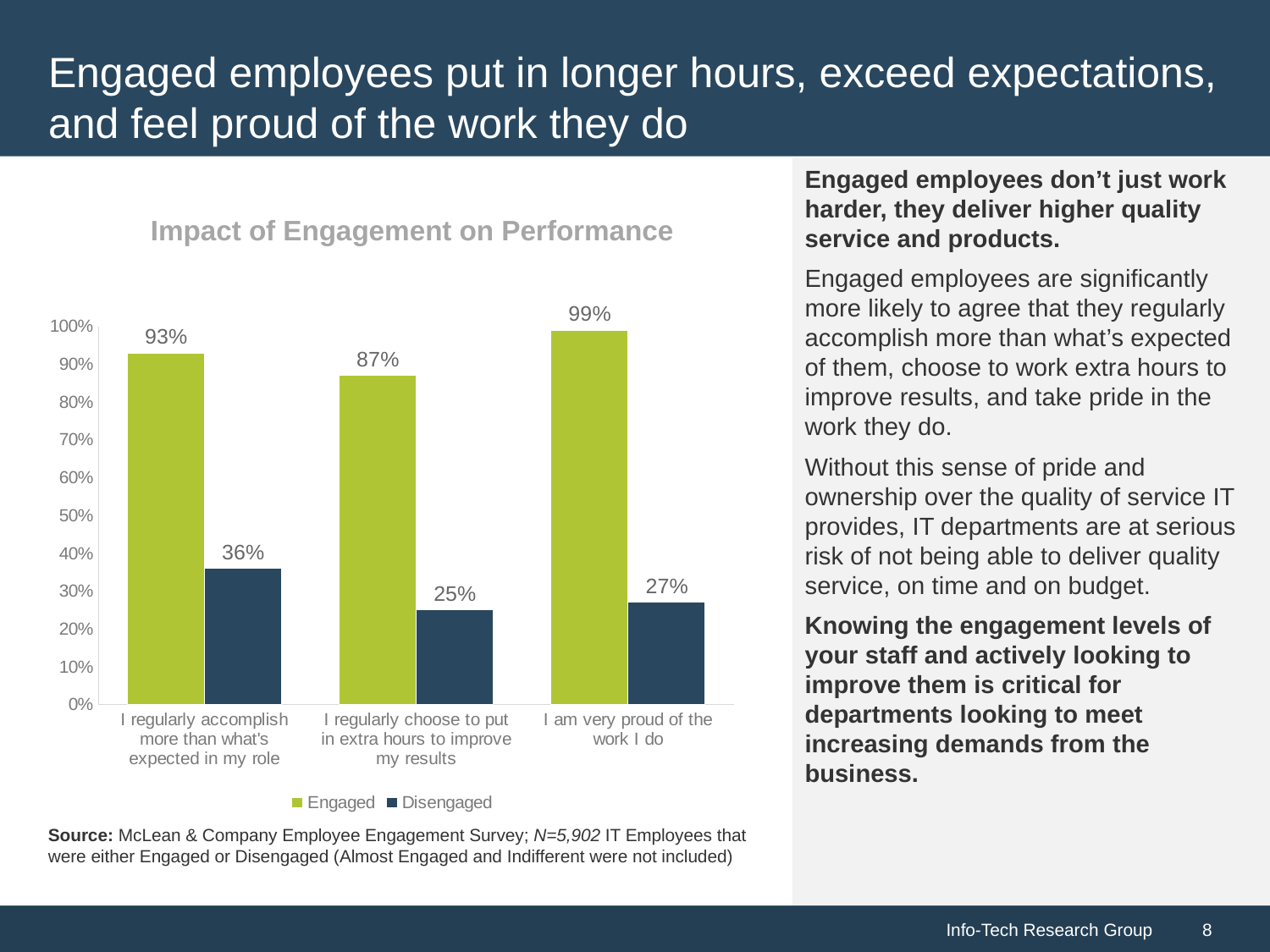
How many categories are shown on the x axis? 3 What is the Engaged value for "I am very proud of the work I do"? 99% What is the title of the chart? Impact of Engagement on Performance What is the difference between the Engaged and Disengaged values for "I regularly accomplish more than what's expected in my role"? 57% Which category has the highest Engaged value? I am very proud of the work I do What is the Disengaged value for "I regularly accomplish more than what's expected in my role"? 36% What kind of chart is shown? bar chart Which category has the lowest Disengaged value? I regularly choose to put in extra hours to improve my results How many series does the legend list? 2 Is the Engaged value for "I regularly choose to put in extra hours to improve my results" greater or less than 80%? greater Which is larger: the Disengaged value for "I regularly accomplish more than what's expected in my role" or the Disengaged value for "I am very proud of the work I do"? I regularly accomplish more than what's expected in my role What is the Disengaged value for "I regularly choose to put in extra hours to improve my results"? 25%